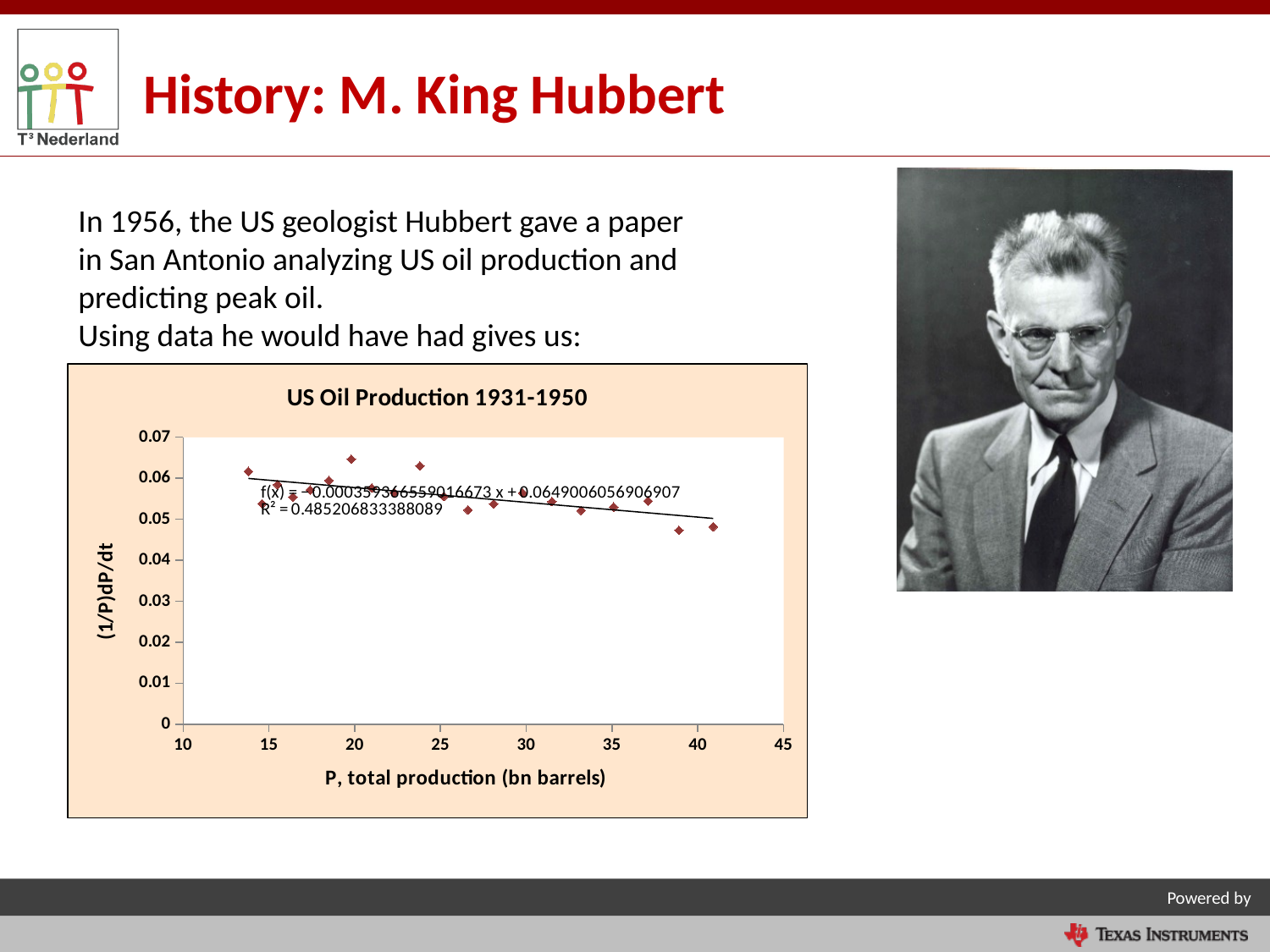
What is the label of the x axis of the chart? P, total production (bn barrels) What is the title of the chart? US Oil Production 1931-1950 What is the intercept of the trendline equation printed on the chart? 0.0649006056906907 Which is larger, the value at about P = 20 or the value at about P = 39? The value at about P = 20 Is the value for the point at about P = 39 greater or less than 0.05? less What R² value is printed on the chart for the trendline? R² = 0.485206833388089 What kind of chart is shown on the slide? Scatter chart Are all the plotted points greater or less than 0.04 on the (1/P)dP/dt axis? greater What is the slope of the trendline equation printed on the chart? -0.000359366559016673 Do the plotted values generally rise or fall as P, total production increases? Fall Is the value for the point at about P = 20 greater or less than 0.06? greater Is the trendline sloping upward or downward from left to right? Downward